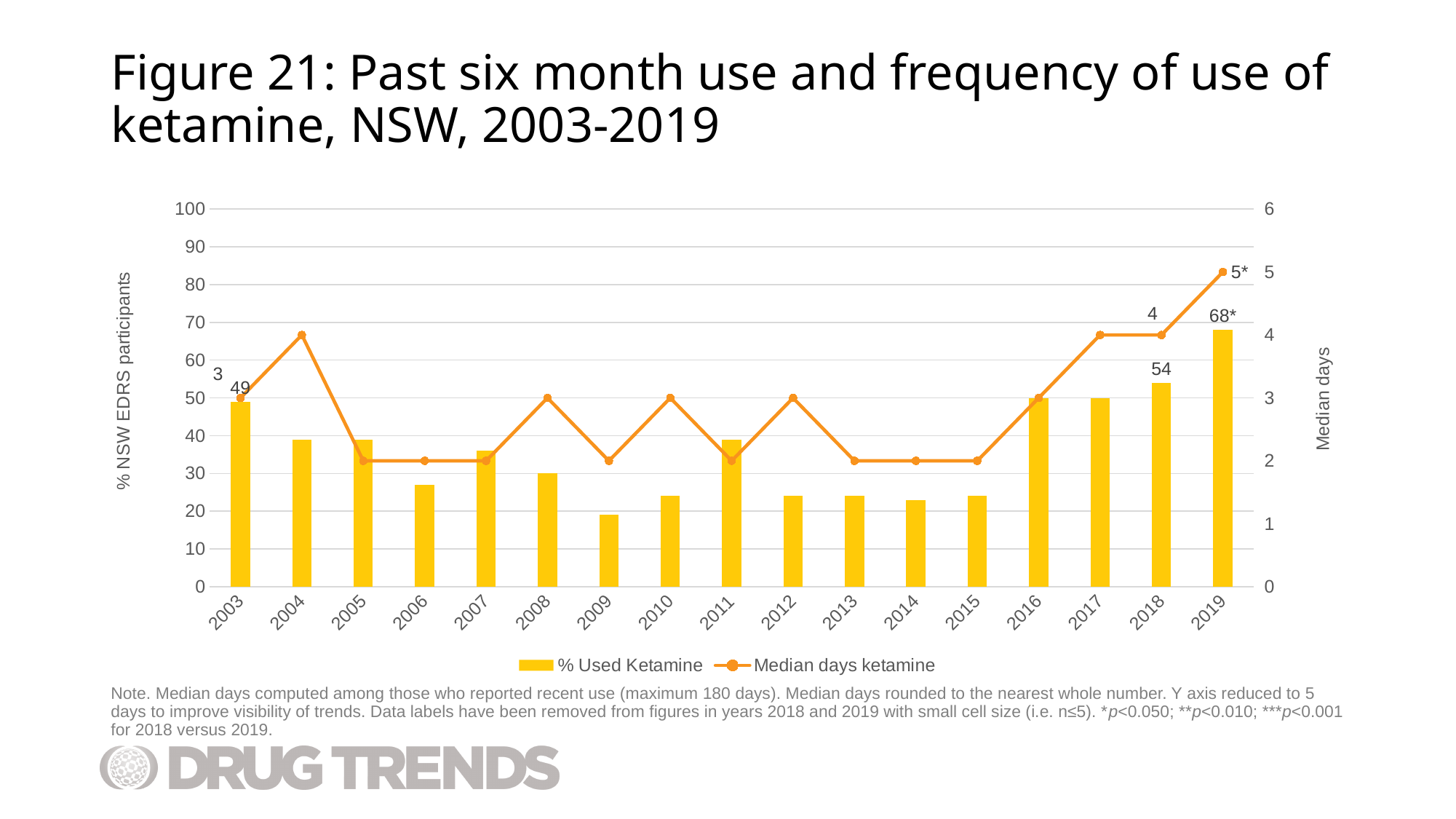
What is the data label on the % Used Ketamine bar for 2019? 68* Which year has the lowest % Used Ketamine? 2009 Does the median days ketamine line rise or fall from 2015 to 2019? rise How many years are shown on the x axis? 17 What percentage of NSW EDRS participants reported using ketamine in 2003? 49 What is the median days ketamine value shown for 2019? 5* What is the median days ketamine value for 2004? 4 How many series does the legend list? 2 Which year has the highest % Used Ketamine? 2019 By how many percentage points did % Used Ketamine increase from 2018 to 2019? 14 What is the % Used Ketamine value for 2018? 54